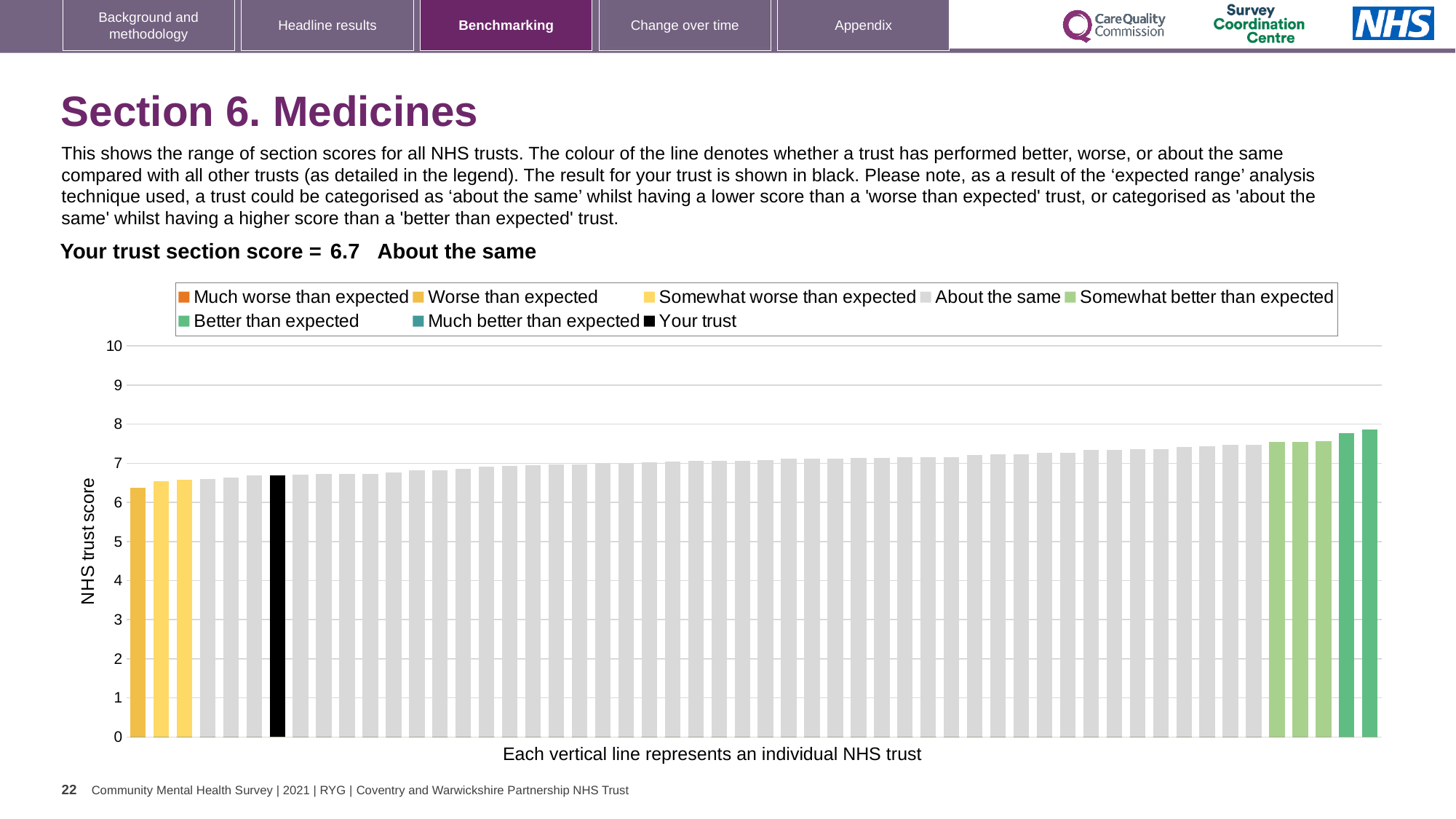
Is the value of the leftmost bar in the chart greater or less than 7? less How many bars are coloured as 'Somewhat better than expected' (light green)? 3 What is the section score for your trust shown on the slide? 6.7 Which category is your trust placed in for Section 6. Medicines? About the same What is the label on the vertical axis of the chart? NHS trust score How many bars are coloured as 'Better than expected' (dark green)? 2 Is the value of the tallest bar in the chart greater or less than 7? greater Do the bar values rise or fall moving from left to right along the x axis? rise What kind of chart is shown on the slide? bar chart How many entries does the chart legend list? 8 Is the value for your trust (the black bar) greater or less than 5? greater Which is larger: the value of the rightmost bar or the value of your trust's black bar? the rightmost bar